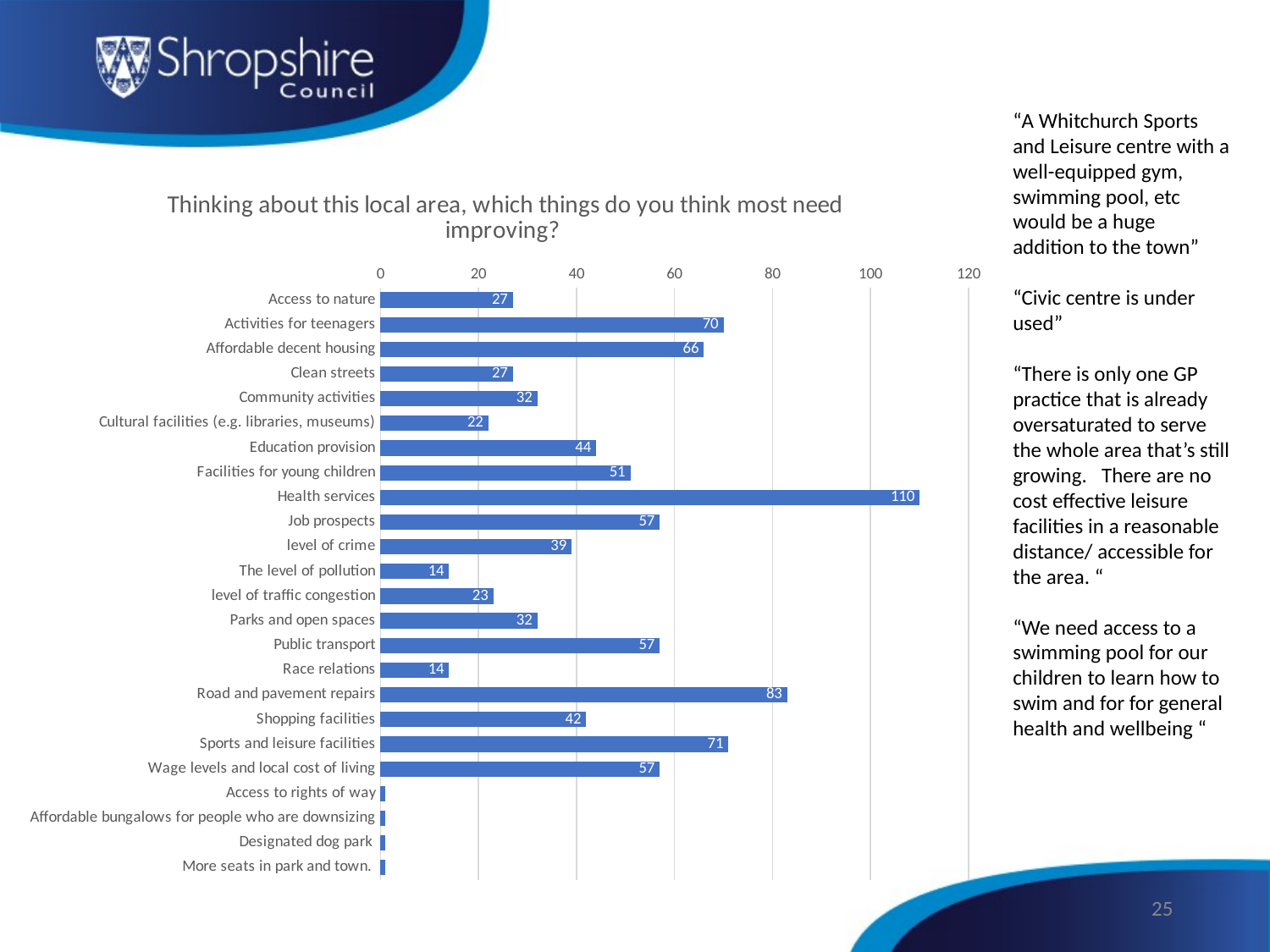
What is the difference between the values for Sports and leisure facilities and Activities for teenagers? 1 What is the title of the chart? Thinking about this local area, which things do you think most need improving? Which is larger, the value for Affordable decent housing or the value for Activities for teenagers? Activities for teenagers What kind of chart is shown on the slide? bar chart How many categories are shown on the chart? 24 What is the value for Cultural facilities (e.g. libraries, museums)? 22 Which is larger, the value for Shopping facilities or the value for level of crime? Shopping facilities What is the difference between the values for Health services and Road and pavement repairs? 27 Is the value for Education provision greater or less than 40? greater What is the value for Road and pavement repairs? 83 What is the value for Health services? 110 Which category has the highest value? Health services